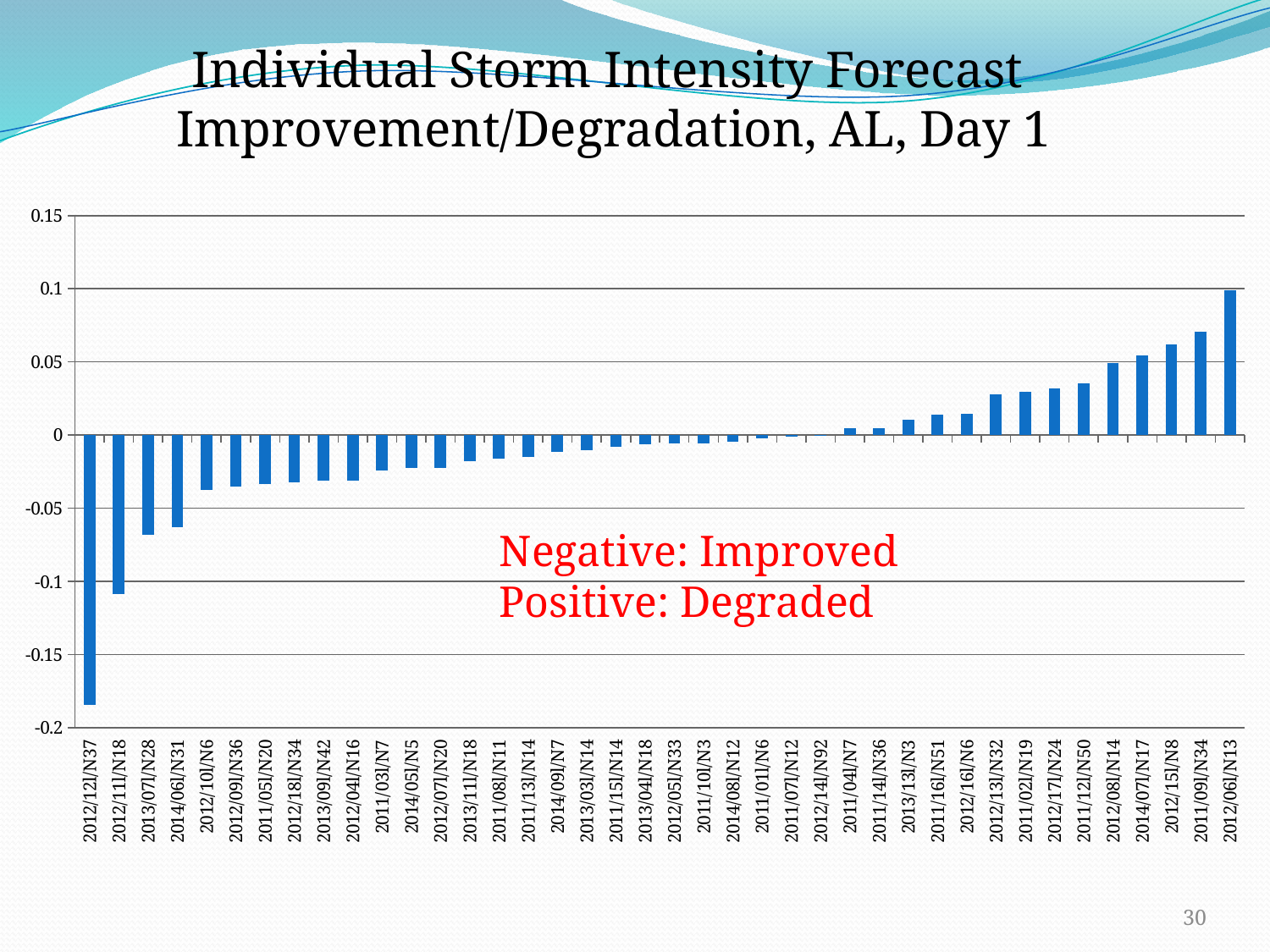
What is the title of the chart? Individual Storm Intensity Forecast Improvement/Degradation, AL, Day 1 Is the value for 2012/06l/N13 greater or less than 0.05? greater Is the value for 2012/11l/N18 greater or less than -0.1? less Which category has the highest value? 2012/06l/N13 Is the value for 2011/09l/N34 greater or less than 0.05? greater What kind of chart is shown on the slide? bar chart Which category has the lowest (most negative) value? 2012/12l/N37 According to the annotation on the chart, what does a negative value indicate? Improved Do the bar values rise or fall moving from left to right along the x axis? rise Which has the lower value, 2012/12l/N37 or 2012/11l/N18? 2012/12l/N37